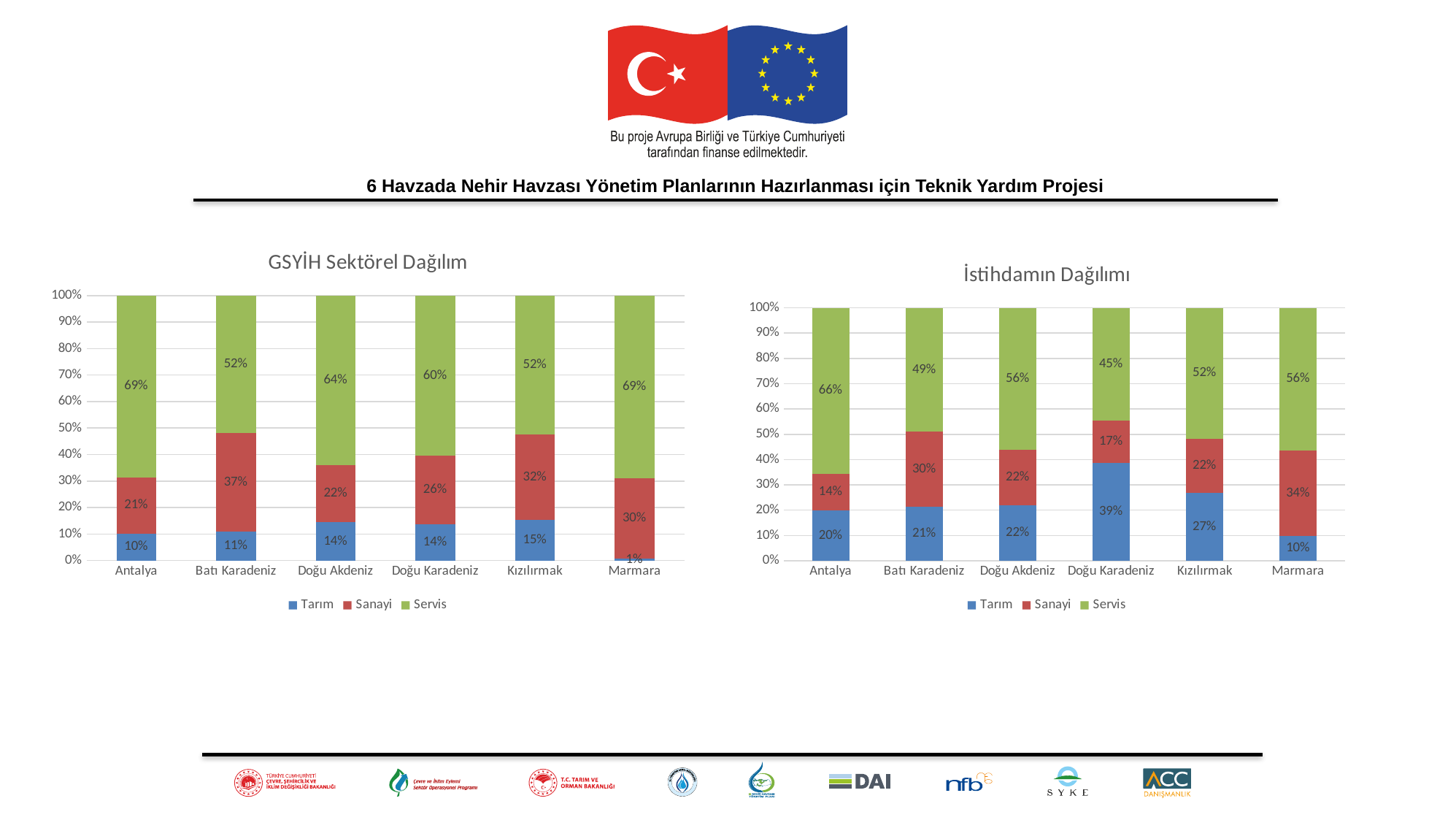
In the GSYİH Sektörel Dağılım chart, which category has the highest Sanayi value? Batı Karadeniz In the GSYİH Sektörel Dağılım chart, which category has the lowest Tarım value? Marmara In the GSYİH Sektörel Dağılım chart, what is the difference between the Servis values for Antalya and Doğu Karadeniz? 9% In the GSYİH Sektörel Dağılım chart, what is the Sanayi value for Batı Karadeniz? 37% In the İstihdamın Dağılımı chart, which category has the lowest Servis value? Doğu Karadeniz In the İstihdamın Dağılımı chart, is the Sanayi value for Marmara larger or smaller than the Sanayi value for Antalya? larger In the GSYİH Sektörel Dağılım chart, what is the Tarım value for Marmara? 1% In the İstihdamın Dağılımı chart, what is the Tarım value for Doğu Karadeniz? 39% In the İstihdamın Dağılımı chart, what is the Servis value for Batı Karadeniz? 49% How many categories are shown on the x axis of the GSYİH Sektörel Dağılım chart? 6 In the İstihdamın Dağılımı chart, which category has the highest Tarım value? Doğu Karadeniz How many series does the legend of the İstihdamın Dağılımı chart list? 3